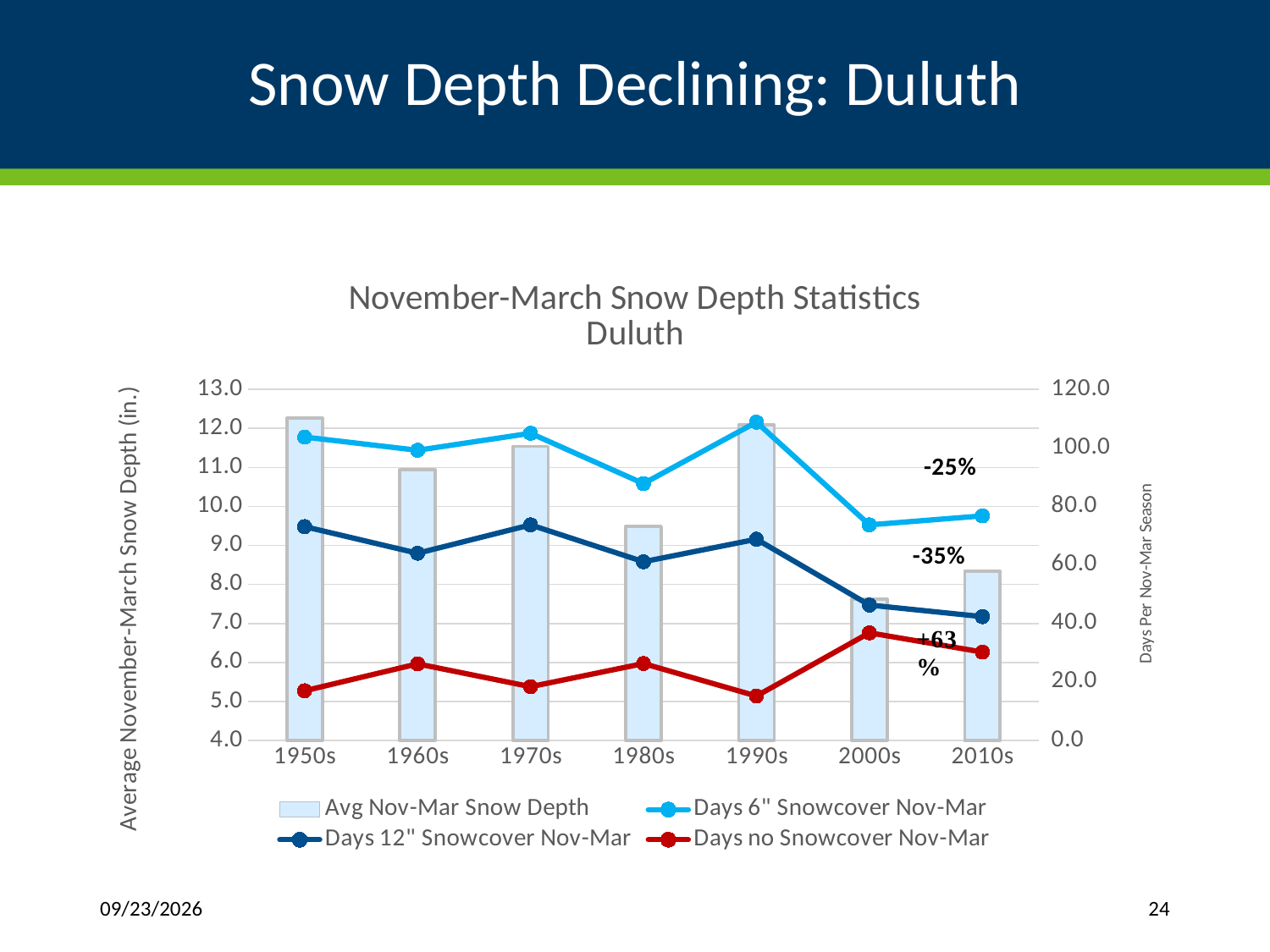
What kind of chart is shown on the slide? Combined bar and line chart How many decades are shown on the x axis? 7 How many series does the legend list? 4 Does the Days 12" Snowcover Nov-Mar line rise or fall from the 1990s to the 2010s? fall Which is larger, Days 6" Snowcover Nov-Mar in the 1990s or in the 1980s? 1990s Is the value for Days no Snowcover Nov-Mar in the 1990s greater or less than 20.0 days? less Is the Avg Nov-Mar Snow Depth for the 2010s greater or less than 9.0 inches? less Is the value for Days 6" Snowcover Nov-Mar in the 2000s greater or less than 80.0 days? less Which decade has the highest Avg Nov-Mar Snow Depth bar? 1950s Which decade has the highest value for Days no Snowcover Nov-Mar? 2000s Which decade has the lowest Avg Nov-Mar Snow Depth bar? 2000s